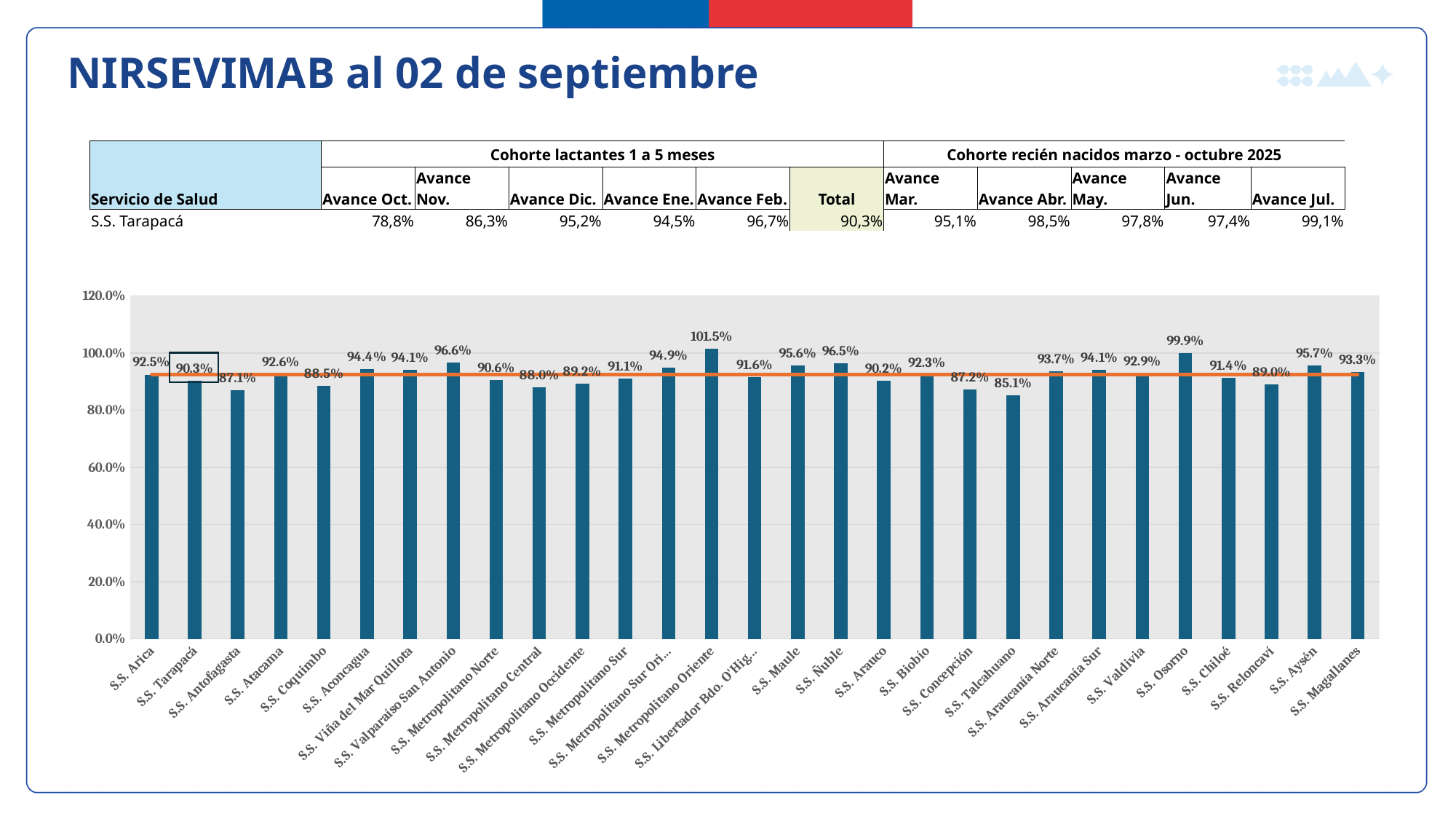
Is the value for S.S. Antofagasta greater or less than 80%? greater What type of chart is shown on the slide? Combination bar and line chart (bars with an orange line) What is the highest value labelled on the vertical axis of the chart? 120.0% What is the value shown for S.S. Valparaíso San Antonio in the bar chart? 96.6% How many Servicios de Salud are shown as bars in the chart? 29 What is the difference between the values for S.S. Metropolitano Oriente and S.S. Talcahuano? 16.4% What is the difference between the values for S.S. Ñuble and S.S. Maule? 0.9% What is the value shown for S.S. Osorno in the bar chart? 99.9% What is the value shown for S.S. Tarapacá in the bar chart? 90.3% Which Servicio de Salud has the lowest value in the bar chart? S.S. Talcahuano Which has a higher value in the bar chart, S.S. Aysén or S.S. Magallanes? S.S. Aysén Which Servicio de Salud has the highest value in the bar chart? S.S. Metropolitano Oriente